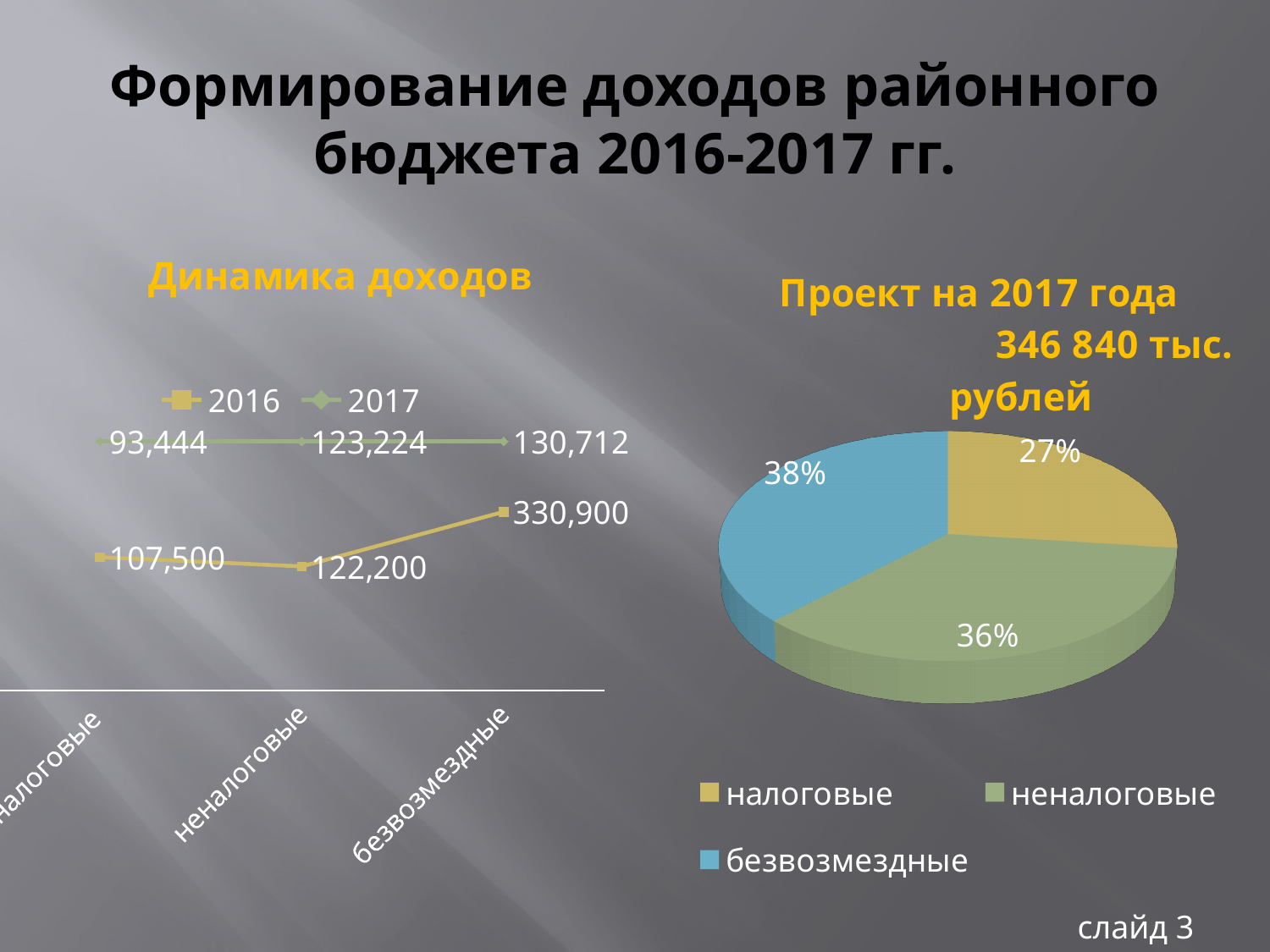
In the 'Динамика доходов' chart, how many categories are shown on the x axis? 3 In the 'Динамика доходов' chart, what is the 2017 value for безвозмездные? 130,712 In the 'Динамика доходов' chart, what is the 2016 value for налоговые? 107,500 In the 'Проект на 2017 года' pie chart, which category has the smallest share? налоговые In the 'Динамика доходов' chart, what is the 2017 value for налоговые? 93,444 What kind of chart is the 'Проект на 2017 года' chart on the right? pie chart In the 'Проект на 2017 года' pie chart, what share is неналоговые? 36% In the 'Проект на 2017 года' pie chart, which category has the largest share? безвозмездные In the 'Динамика доходов' chart, what is the 2016 value for безвозмездные? 330,900 In the 'Динамика доходов' chart, how many series does the legend list? 2 In the 'Динамика доходов' chart, what is the difference between the 2016 and 2017 values for налоговые? 14,056 In the 'Динамика доходов' chart, which is larger for неналоговые: the 2016 value or the 2017 value? 2017